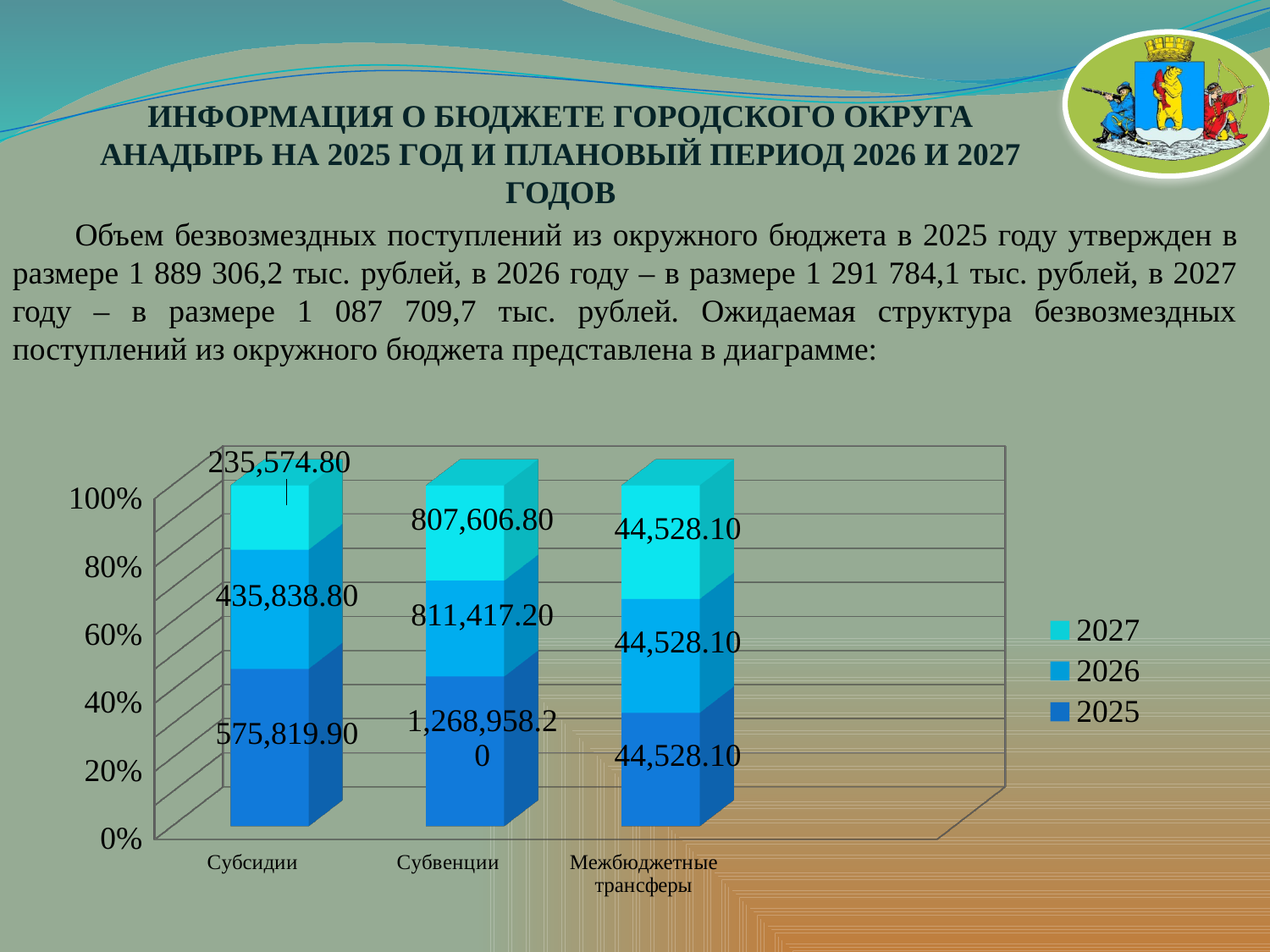
Which category has the highest value for the 2025 series? Субвенции Which is larger for Субвенции: the 2026 value or the 2027 value? 2026 What is the value for 2026 in the Межбюджетные трансферы bar? 44,528.10 Which category has the lowest value for the 2027 series? Межбюджетные трансферы What kind of chart is shown on the slide? Stacked bar chart What is the difference between the 2026 and 2027 values for Субсидии? 200,264.00 What is the total of the three values in the Субсидии bar? 1,247,233.50 How many categories are shown on the x axis? 3 What is the value for 2027 in the Субвенции bar? 807,606.80 What is the value for 2025 in the Субсидии bar? 575,819.90 How many series does the legend list? 3 What is the difference between the 2025 values for Субвенции and Субсидии? 693,138.30